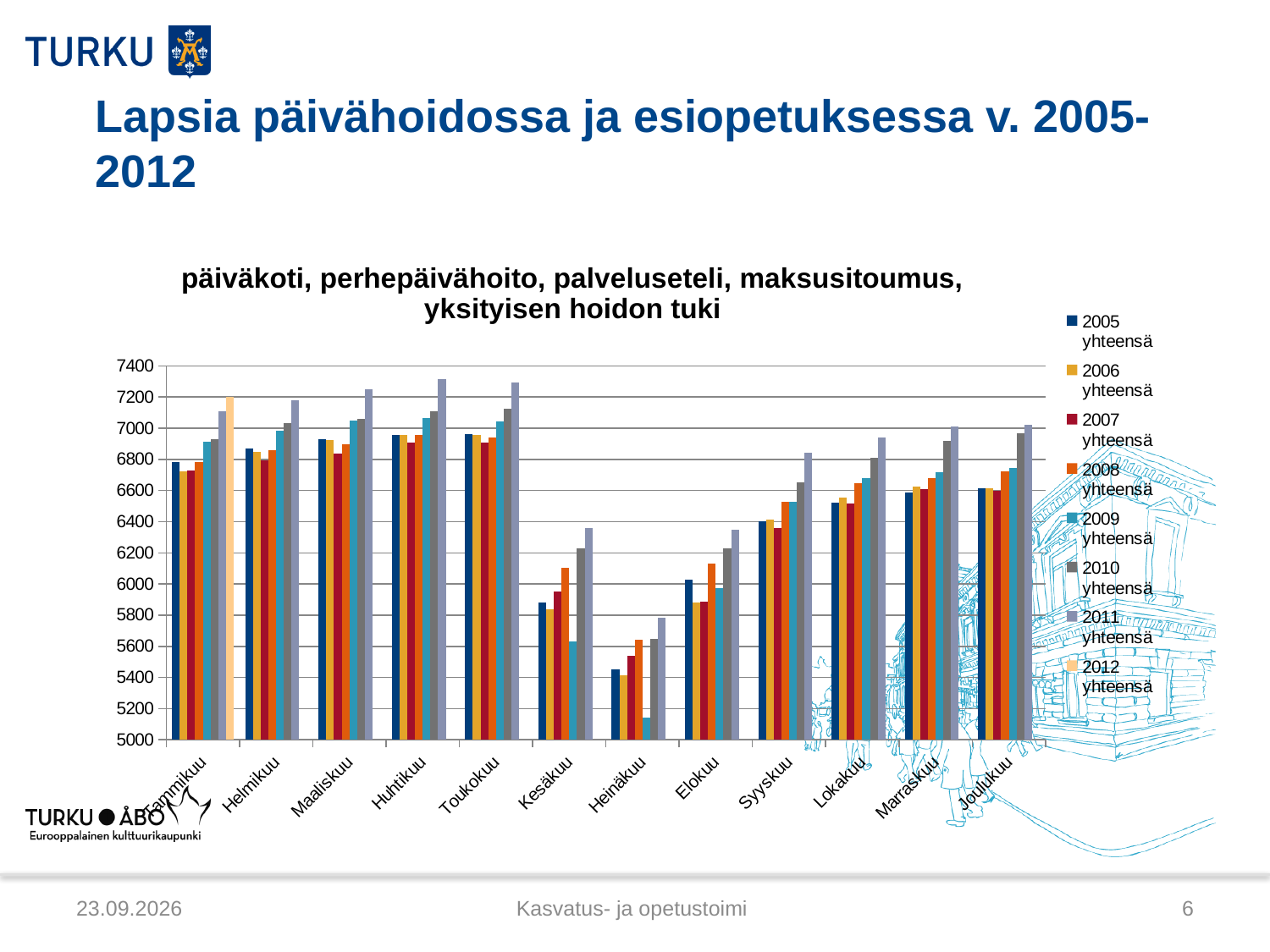
Which month has the lowest bar for the 2005 yhteensä series? Heinäkuu What kind of chart is shown on the slide? bar chart Is the 2005 yhteensä value for Kesäkuu greater or less than 6000? less How many series does the chart legend list? 8 Is the 2011 yhteensä value for Huhtikuu greater or less than 7200? greater Is the 2011 yhteensä value for Lokakuu greater or less than 6800? greater Which month has the lowest bar for the 2011 yhteensä series? Heinäkuu What is the first entry listed in the chart legend? 2005 yhteensä Do the 2011 yhteensä values rise or fall from Heinäkuu to Joulukuu? rise Which is larger: the 2011 yhteensä value for Huhtikuu or for Heinäkuu? Huhtikuu How many months (categories) are shown on the x axis of the chart? 12